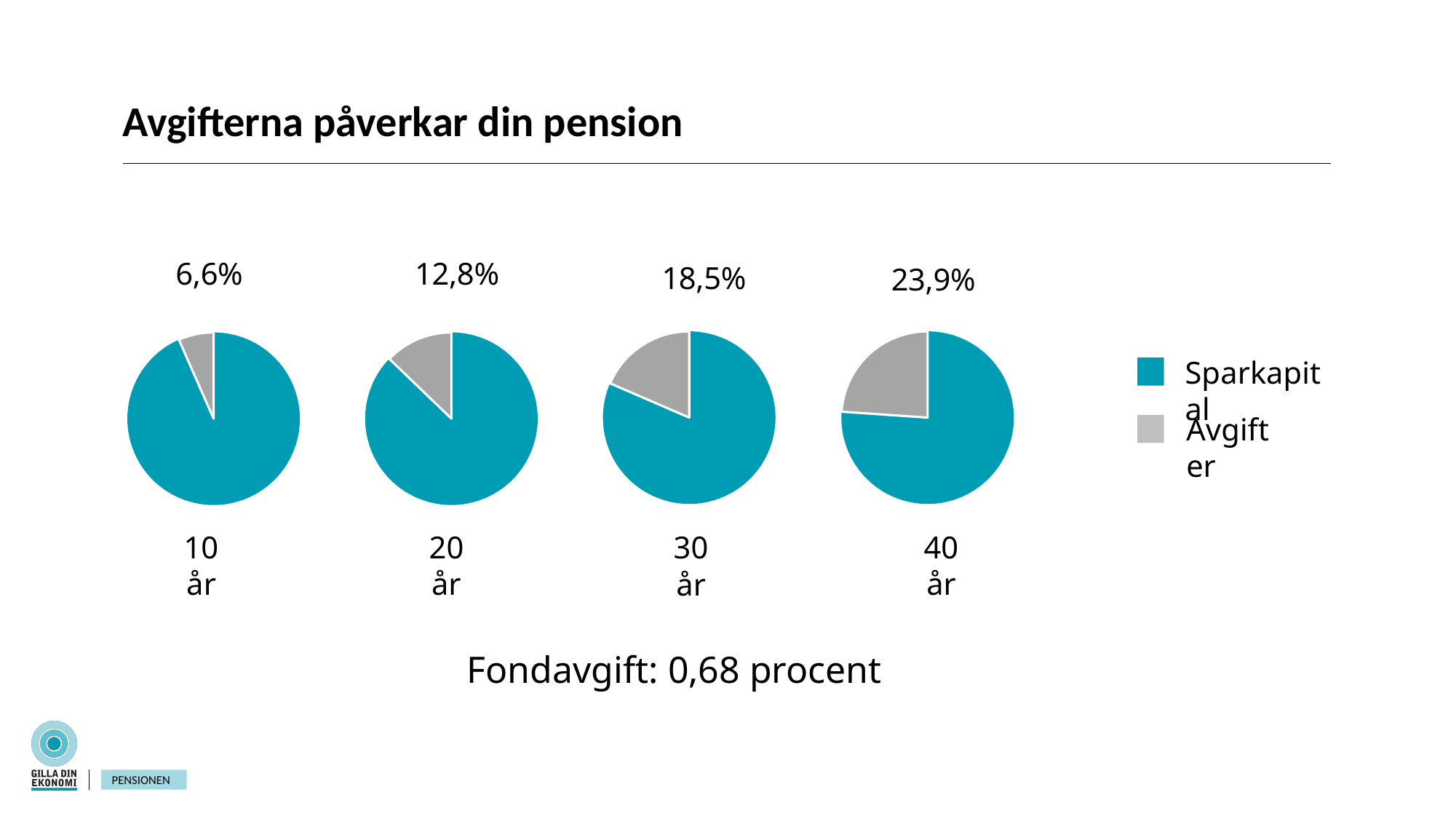
Is the grey Avgifter slice larger in the 30 år pie chart or in the 20 år pie chart? 30 år In the pie chart labelled 10 år, what percentage is shown above the chart? 6,6% Which legend entry is shown in grey? Avgifter Which of the four pie charts has the smallest Avgifter (grey) slice? 10 år What kind of chart is used on the slide? Pie chart What is the difference between the percentage shown for the 40 år pie chart and the percentage shown for the 10 år pie chart? 17,3% In the pie chart labelled 40 år, what percentage is shown above the chart? 23,9% In the pie chart labelled 20 år, what percentage is shown above the chart? 12,8% In the pie chart labelled 30 år, what percentage is shown above the chart? 18,5% Which of the four pie charts has the largest Avgifter (grey) slice? 40 år How many pie charts are shown on the slide? 4 How many series does the legend list for the pie charts? 2